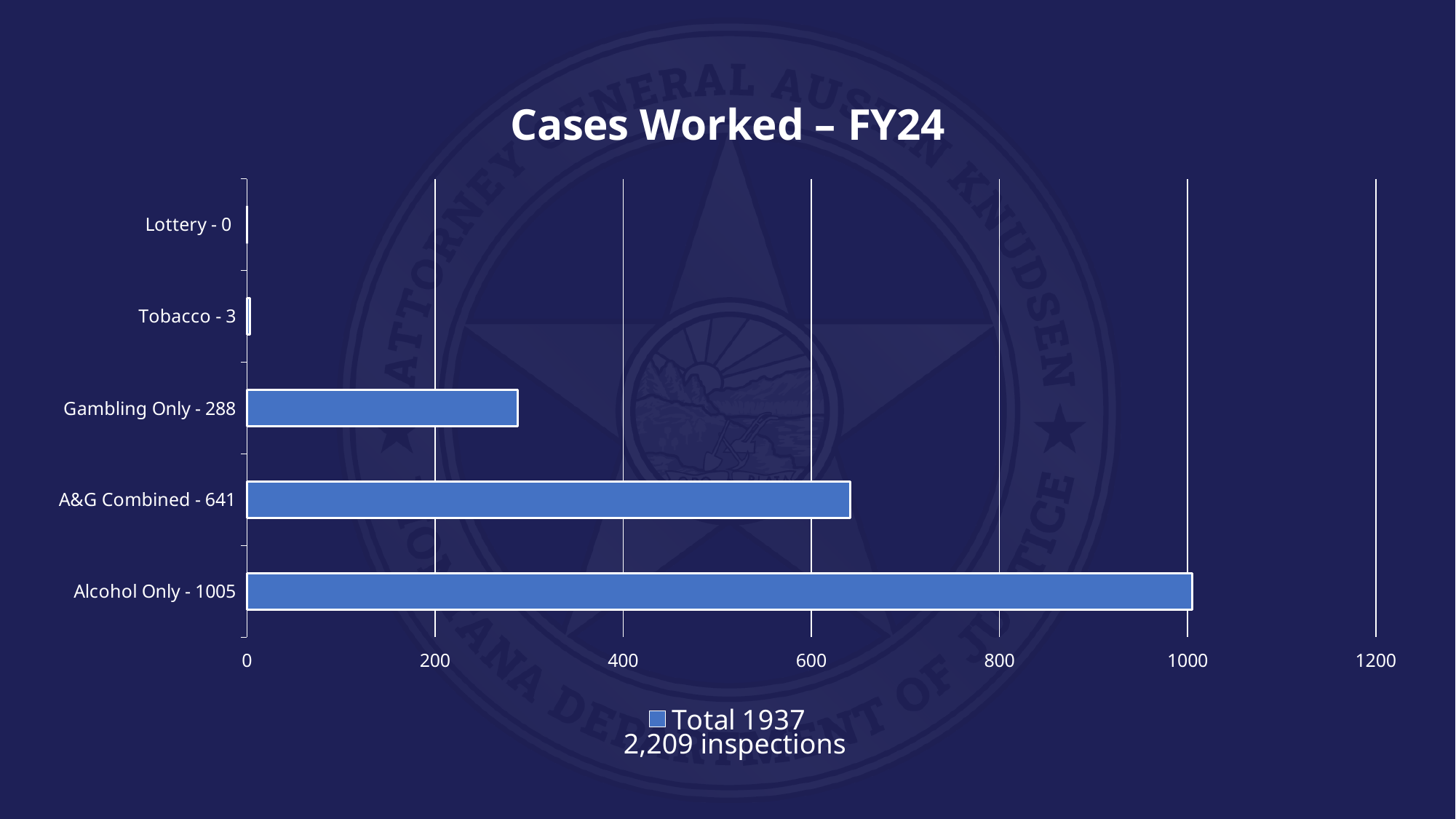
Which category has the highest value? Alcohol Only Is the value for Gambling Only greater or less than 400? less What is the value for A&G Combined? 641 What is the value for Alcohol Only? 1005 What is the difference between the values for Alcohol Only and A&G Combined? 364 What kind of chart is shown on the slide? bar chart What is the value for Tobacco? 3 How many categories are shown on the chart? 5 Which category has the lowest value? Lottery Which is larger, the value for Gambling Only or the value for A&G Combined? A&G Combined What is the value for Gambling Only? 288 What is the title of the chart? Cases Worked – FY24